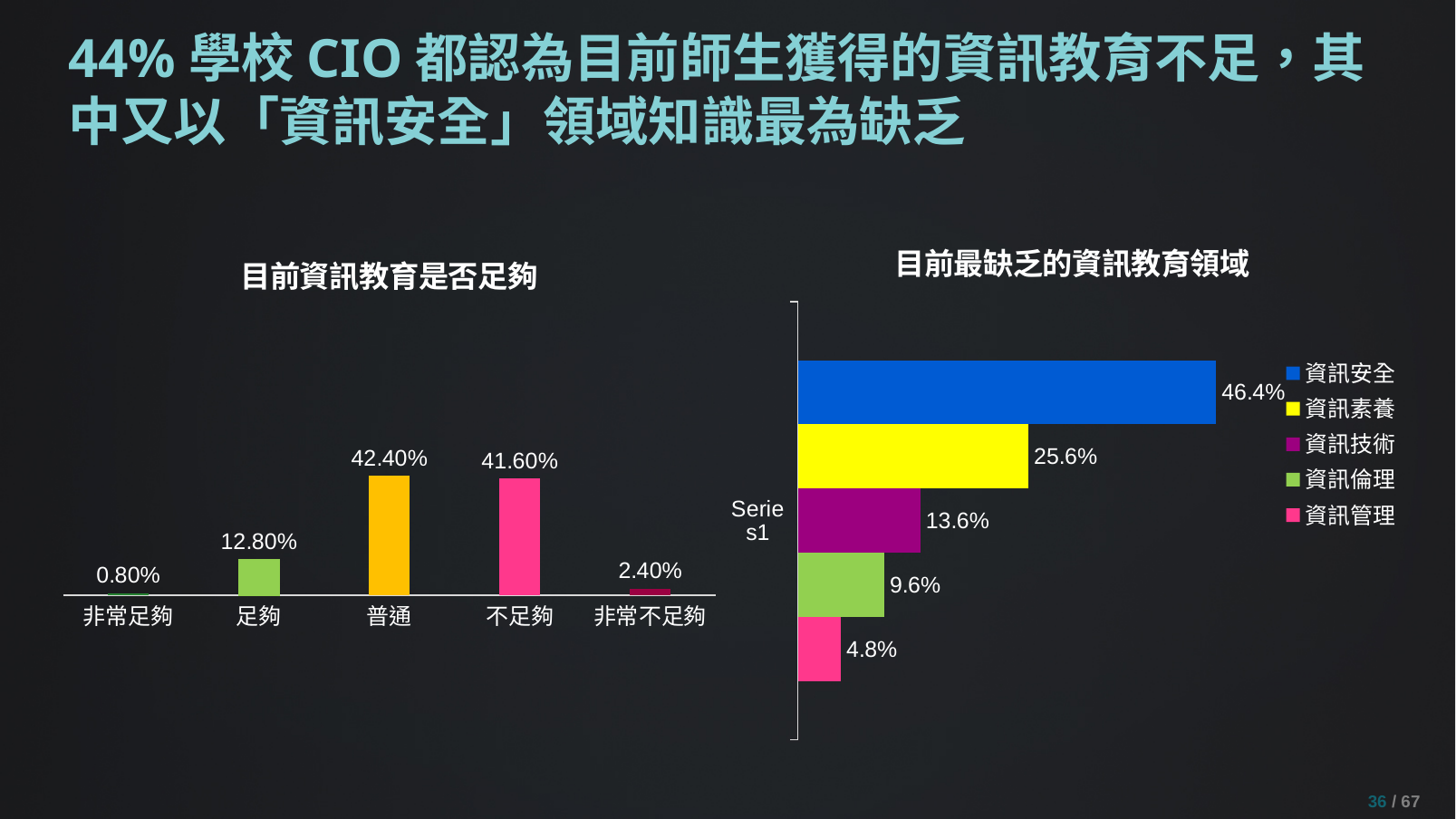
In the chart titled 目前最缺乏的資訊教育領域, which category has the lowest value? 資訊管理 In the chart titled 目前資訊教育是否足夠, which is larger: 足夠 or 不足夠? 不足夠 In the chart titled 目前資訊教育是否足夠, what is the difference between 足夠 and 非常不足夠? 10.40% In the chart titled 目前資訊教育是否足夠, how many categories are shown on the x axis? 5 In the chart titled 目前資訊教育是否足夠, what is the value for 非常足夠? 0.80% In the chart titled 目前資訊教育是否足夠, which category has the lowest value? 非常足夠 In the chart titled 目前最缺乏的資訊教育領域, what is the difference between 資訊安全 and 資訊素養? 20.8% What kind of chart is the chart titled 目前最缺乏的資訊教育領域? Bar chart In the chart titled 目前最缺乏的資訊教育領域, how many entries does the legend list? 5 In the chart titled 目前資訊教育是否足夠, what is the value for 普通? 42.40% In the chart titled 目前最缺乏的資訊教育領域, which category has the highest value? 資訊安全 In the chart titled 目前最缺乏的資訊教育領域, what is the value for 資訊素養? 25.6%